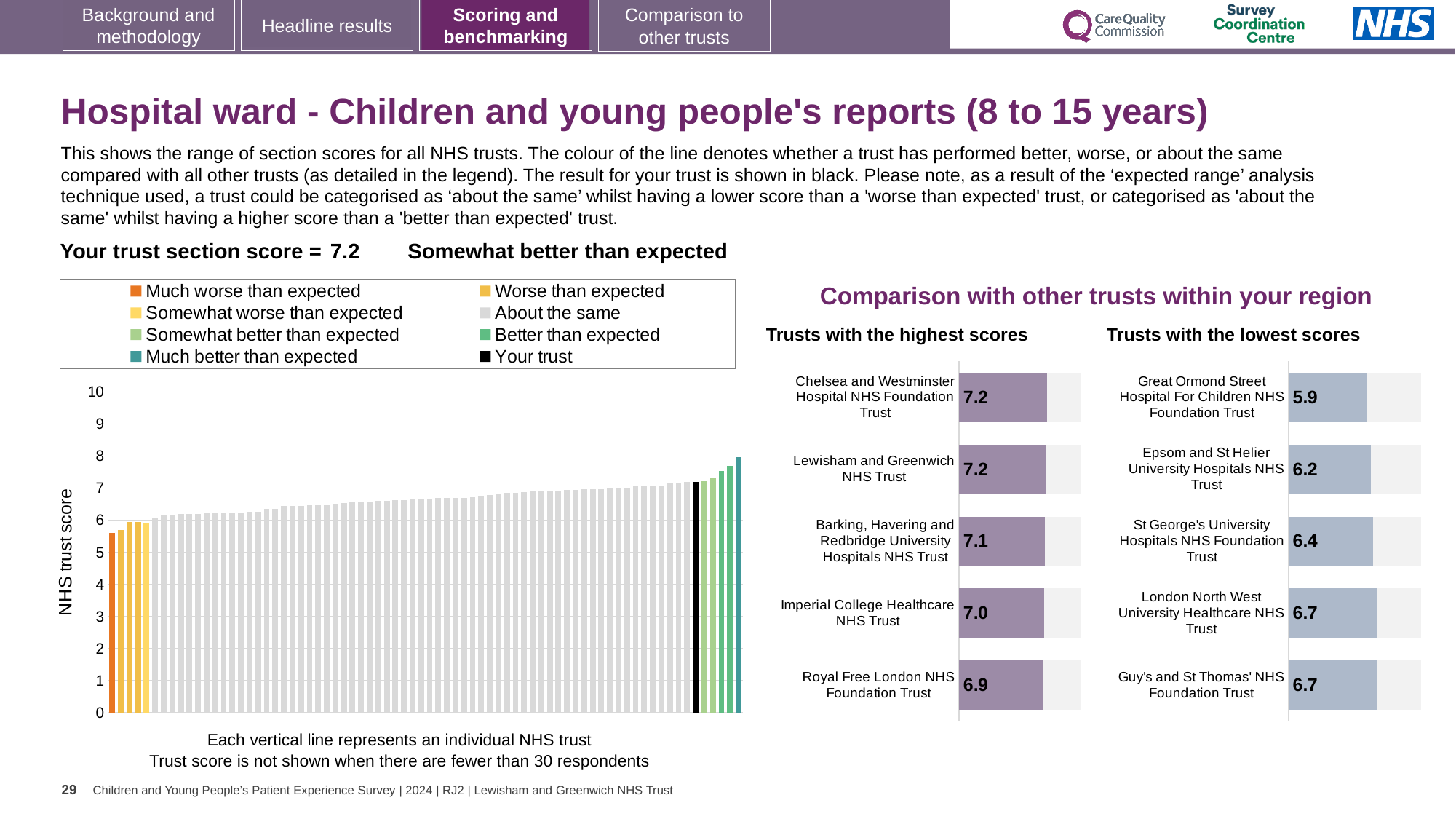
In the 'Trusts with the lowest scores' chart, which trust has the lowest score? Great Ormond Street Hospital For Children NHS Foundation Trust In the 'Trusts with the lowest scores' chart, what is the score for Epsom and St Helier University Hospitals NHS Trust? 6.2 In the large chart on the left, is the value for the leftmost (orange) bar greater or less than 6? less In the large chart on the left, do the bar values rise or fall from left to right? rise What kind of chart is the large chart on the left with the y axis labelled 'NHS trust score'? bar chart In the large chart on the left, how many entries does the legend list? 8 In the 'Trusts with the highest scores' chart, what is the difference between the scores of Chelsea and Westminster Hospital NHS Foundation Trust and Royal Free London NHS Foundation Trust? 0.3 In the 'Trusts with the highest scores' chart, how many trusts are shown? 5 In the 'Trusts with the lowest scores' chart, which is larger: the score for St George's University Hospitals NHS Foundation Trust or the score for Great Ormond Street Hospital For Children NHS Foundation Trust? St George's University Hospitals NHS Foundation Trust In the 'Trusts with the highest scores' chart, what is the score for Barking, Havering and Redbridge University Hospitals NHS Trust? 7.1 In the 'Trusts with the highest scores' chart, which trust has the lowest score? Royal Free London NHS Foundation Trust In the large chart on the left, is the value for the black 'Your trust' bar greater or less than 7? greater